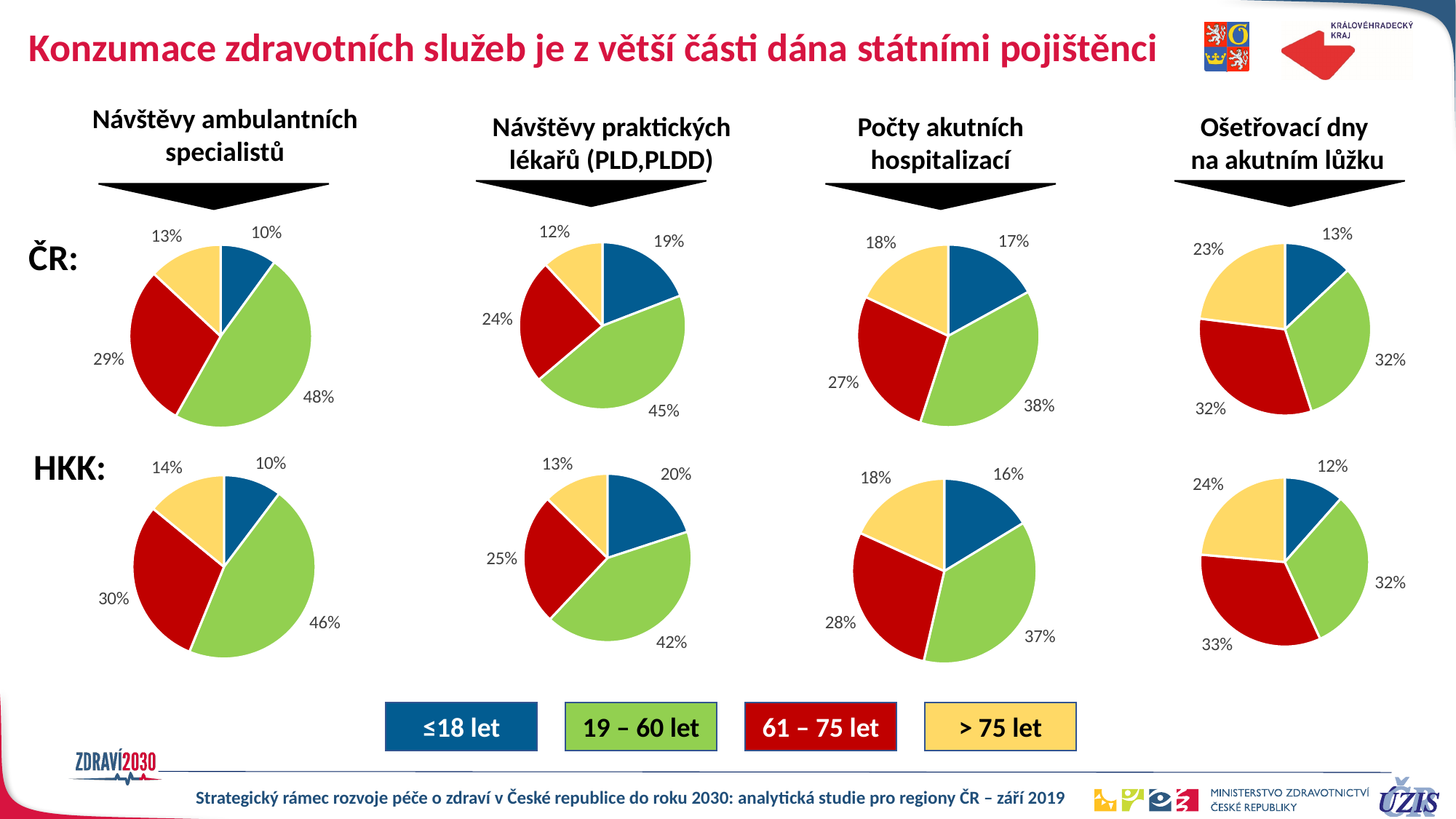
In the HKK pie chart for Ošetřovací dny na akutním lůžku, what share is shown for the > 75 let group? 24% In the HKK pie chart for Návštěvy praktických lékařů (PLD,PLDD), what share is shown for the ≤18 let group? 20% In the ČR pie chart for Návštěvy ambulantních specialistů, what share is shown for the 19 – 60 let group? 48% In the HKK pie chart for Ošetřovací dny na akutním lůžku, which is larger: the share for 61 – 75 let or the share for > 75 let? 61 – 75 let Which colour represents the 61 – 75 let group in the legend? Red How many age groups does the legend list? 4 In the ČR pie chart for Počty akutních hospitalizací, what share is shown for the 61 – 75 let group? 27% In the HKK pie chart for Návštěvy ambulantních specialistů, which age group has the largest share? 19 – 60 let What type of chart is used for the ČR Ošetřovací dny na akutním lůžku data? Pie chart In the ČR pie chart for Počty akutních hospitalizací, what is the difference between the 19 – 60 let share and the 61 – 75 let share? 11 percentage points How many pie charts are shown on the slide? 8 In the ČR pie chart for Návštěvy praktických lékařů (PLD,PLDD), which age group has the smallest share? > 75 let